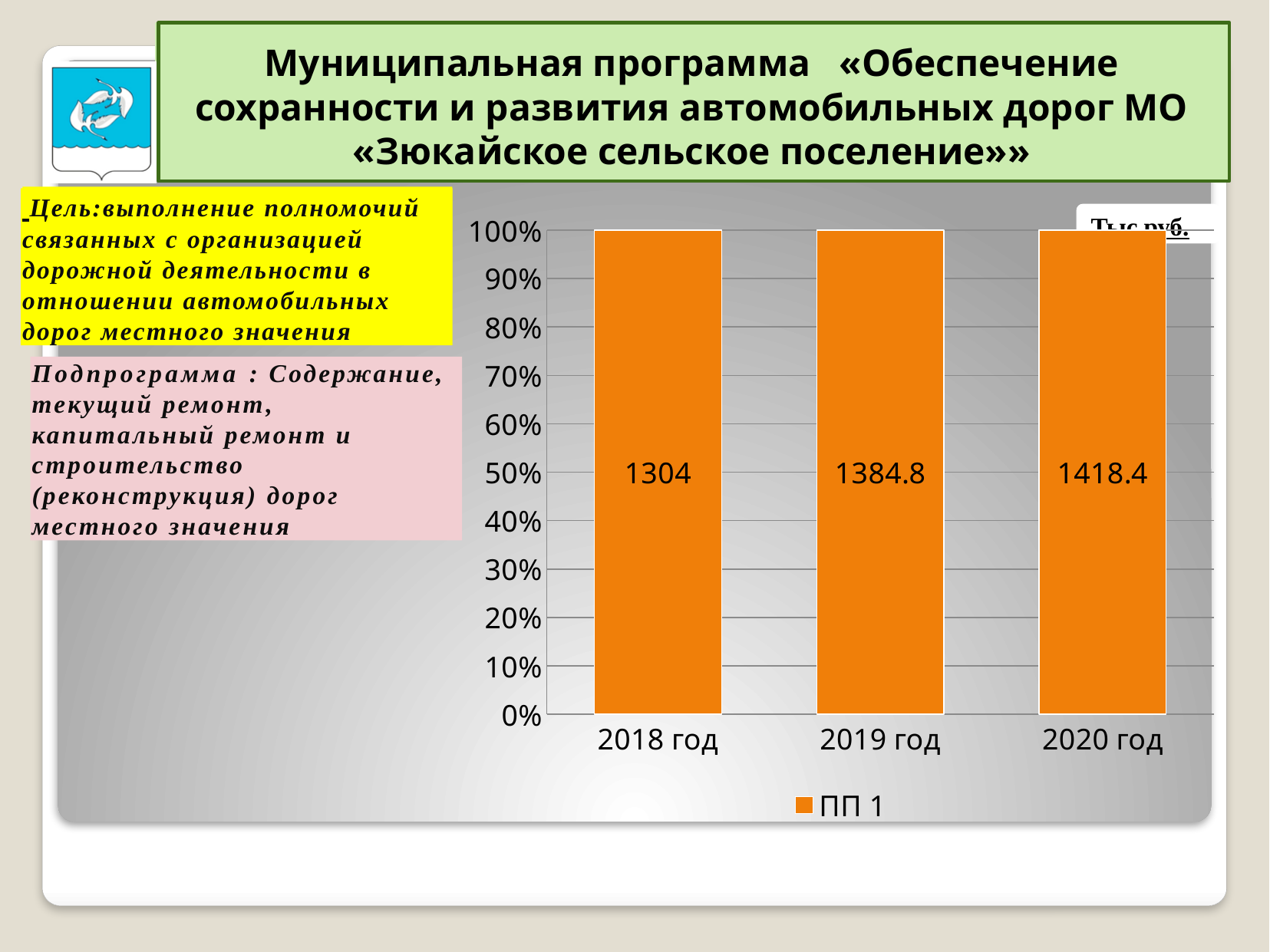
Which year has the lowest labelled value? 2018 год How many series does the legend list? 1 Which has the larger labelled value, 2019 год or 2020 год? 2020 год How many years are shown on the x axis? 3 What is the data label on the bar for 2018 год? 1304 What kind of chart is shown? bar chart What is the difference between the labelled values for 2019 год and 2018 год? 80.8 What is the data label on the bar for 2019 год? 1384.8 What is the difference between the labelled values for 2020 год and 2019 год? 33.6 Which year has the highest labelled value? 2020 год What is the data label on the bar for 2020 год? 1418.4 Do the labelled values rise or fall from 2018 год to 2020 год? rise